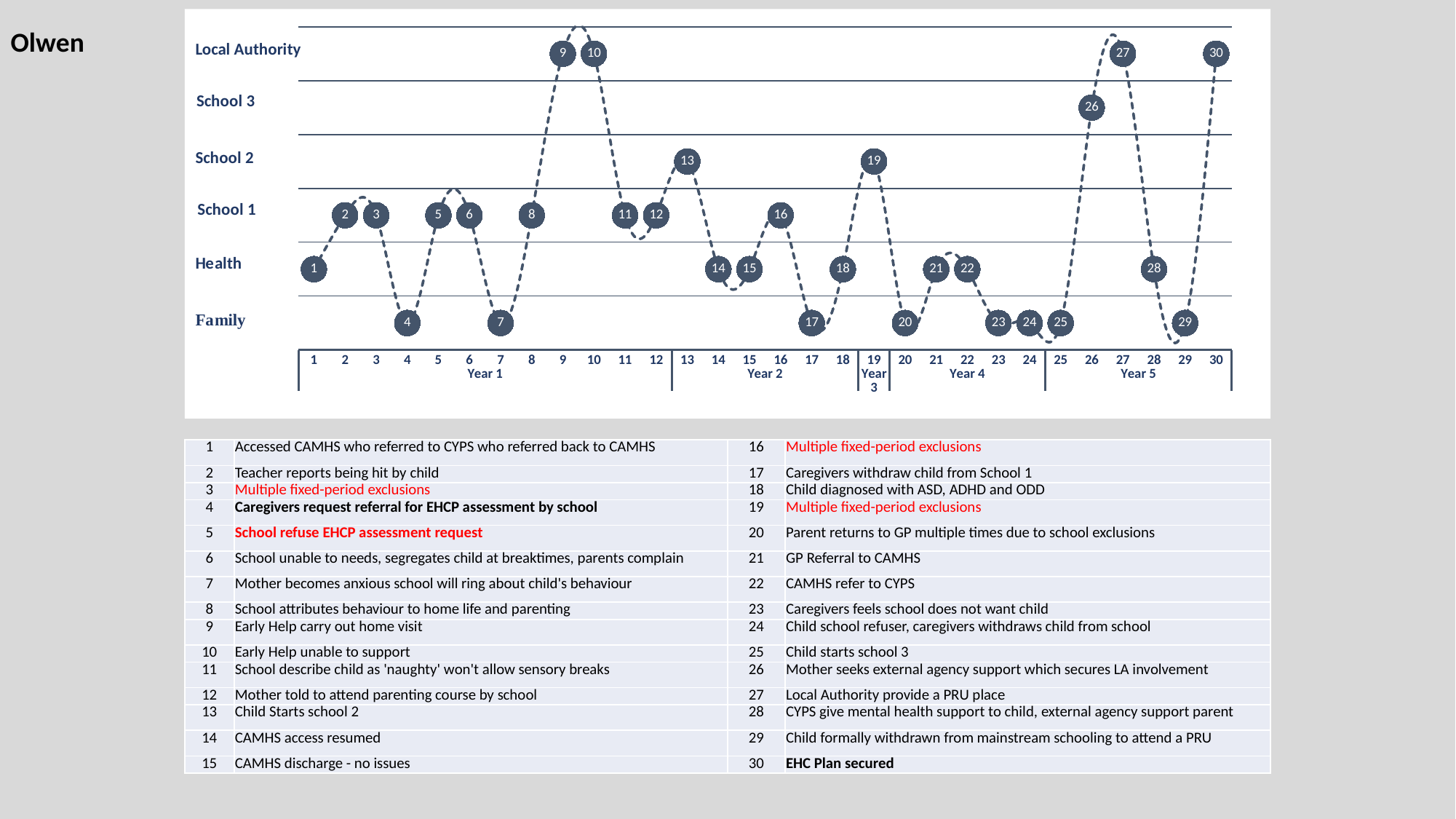
Which year on the x axis contains the most events? Year 1 Which year on the x axis contains the fewest events? Year 3 What is the name shown at the top left of the slide above the chart? Olwen On which row of the chart is event 26 plotted? School 3 How many numbered events are plotted on the chart? 30 Which events fall within Year 3 on the x axis? 19 What does the table say event 30 is? EHC Plan secured How many category rows (e.g. Local Authority, Family) does the chart's vertical axis show? 6 On which row of the chart is event 13 plotted? School 2 How many events are plotted on the School 3 row? 1 On which row of the chart is event 1 plotted? Health